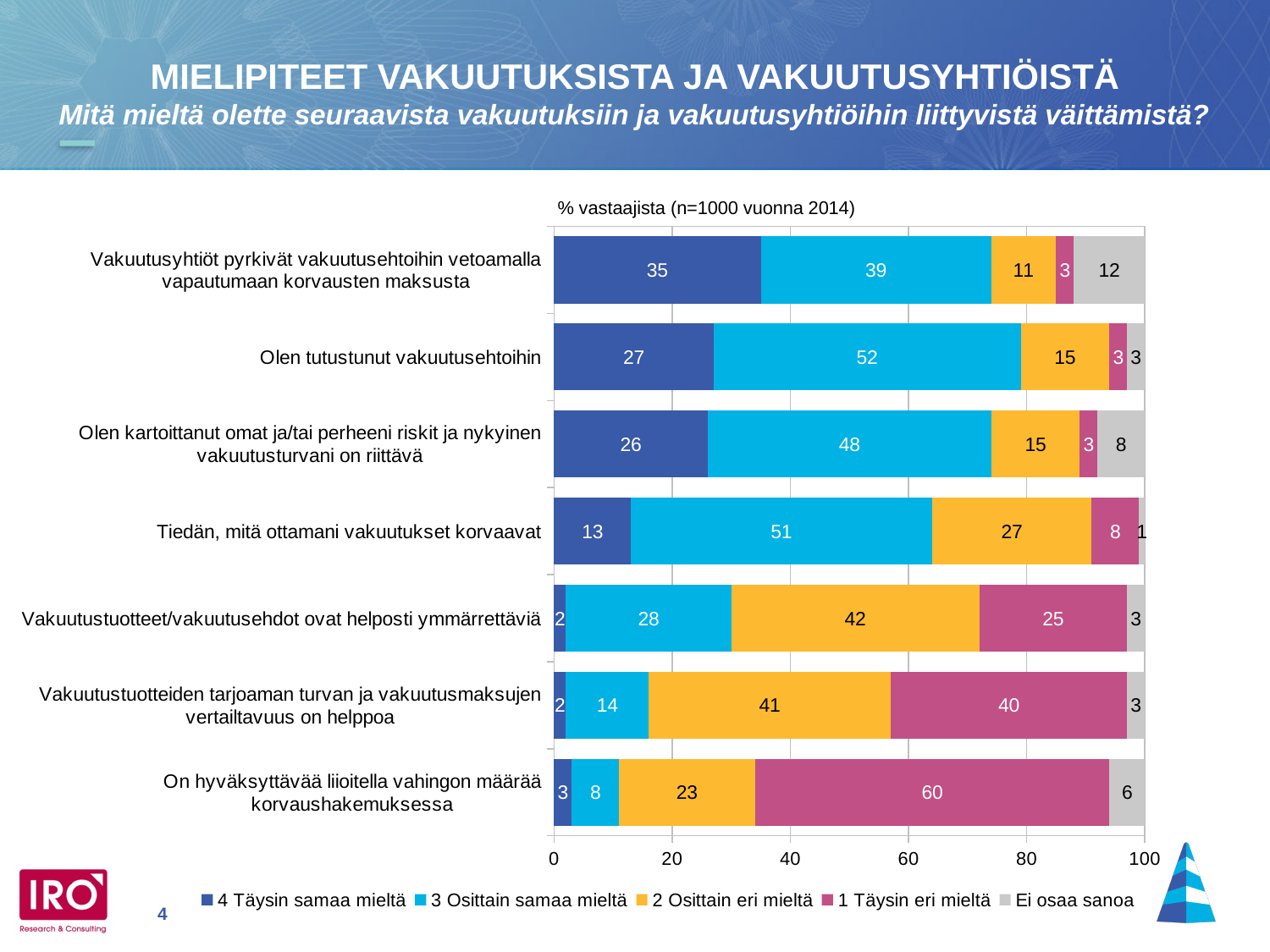
What is the subtitle text shown above the chart? % vastaajista (n=1000 vuonna 2014) How many series does the legend list? 5 How many statements (categories) are plotted in the chart? 7 Which statement has the highest value for '4 Täysin samaa mieltä'? Vakuutusyhtiöt pyrkivät vakuutusehtoihin vetoamalla vapautumaan korvausten maksusta What is the difference between the '2 Osittain eri mieltä' values for 'Vakuutustuotteet/vakuutusehdot ovat helposti ymmärrettäviä' and 'Tiedän, mitä ottamani vakuutukset korvaavat'? 15 What is the value of '1 Täysin eri mieltä' for 'On hyväksyttävää liioitella vahingon määrää korvaushakemuksessa'? 60 What type of chart is shown on the slide? Stacked bar chart Which is larger: the '1 Täysin eri mieltä' value for 'Vakuutustuotteiden tarjoaman turvan ja vakuutusmaksujen vertailtavuus on helppoa' or for 'Vakuutustuotteet/vakuutusehdot ovat helposti ymmärrettäviä'? Vakuutustuotteiden tarjoaman turvan ja vakuutusmaksujen vertailtavuus on helppoa What is the total of the stacked bar for 'Olen kartoittanut omat ja/tai perheeni riskit ja nykyinen vakuutusturvani on riittävä'? 100 What is the value of 'Ei osaa sanoa' for 'Vakuutusyhtiöt pyrkivät vakuutusehtoihin vetoamalla vapautumaan korvausten maksusta'? 12 What is the value of '3 Osittain samaa mieltä' for 'Olen tutustunut vakuutusehtoihin'? 52